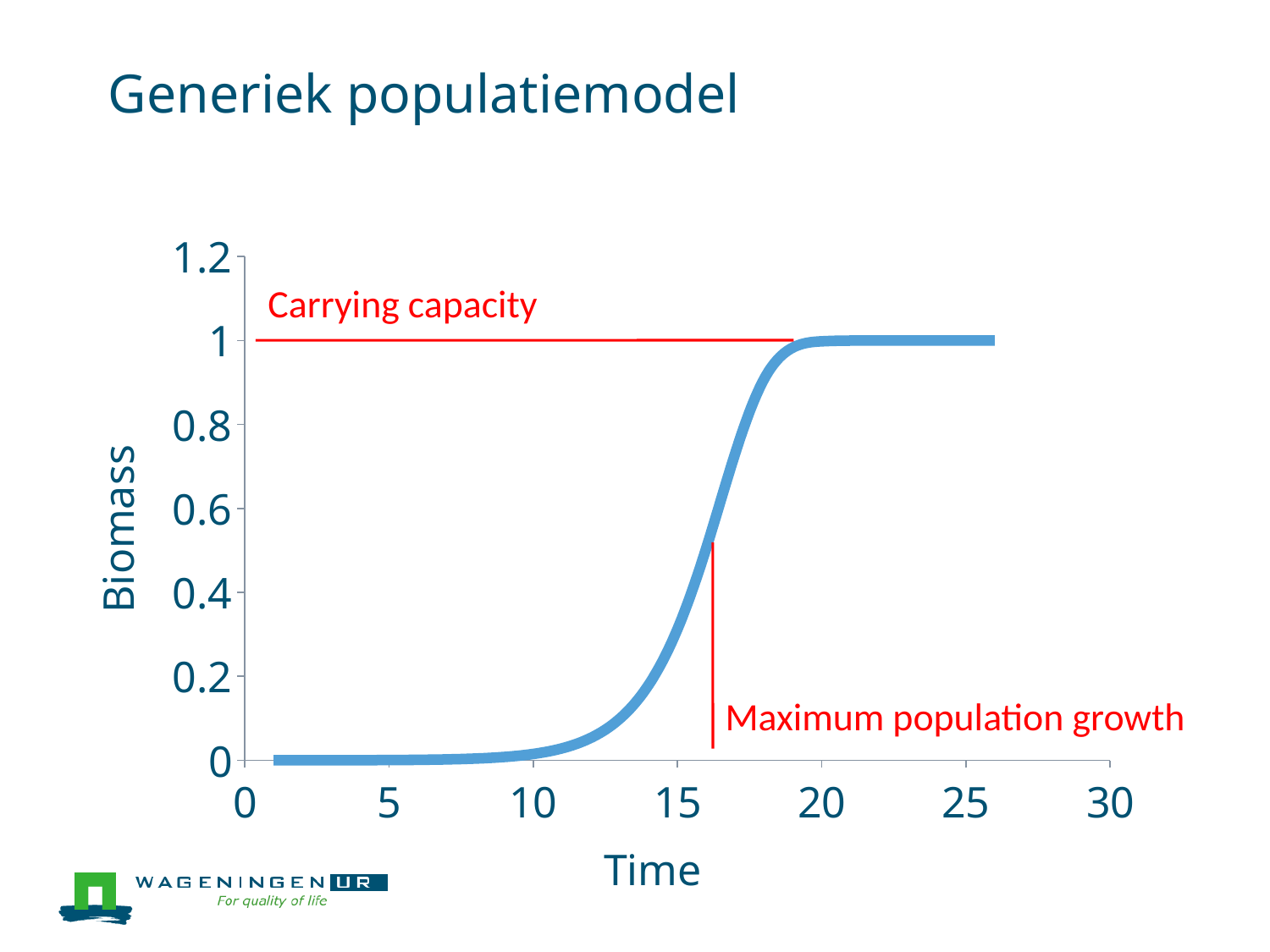
What is the highest value shown on the Biomass axis? 1.2 What is the title of the slide containing the chart? Generiek populatiemodel Does the Biomass curve rise or fall as Time increases? rise Is the Biomass value at Time 15 greater or less than 0.6? less At what Biomass value is the red Carrying capacity line drawn? 1 Which is larger, the Biomass at Time 10 or the Biomass at Time 20? Time 20 Is the Biomass value at Time 25 greater or less than 0.6? greater What kind of chart is shown on the slide? line chart What is the highest value shown on the Time axis? 30 Is the Biomass value at Time 20 greater or less than 0.8? greater What label is given to the vertical red line on the chart? Maximum population growth